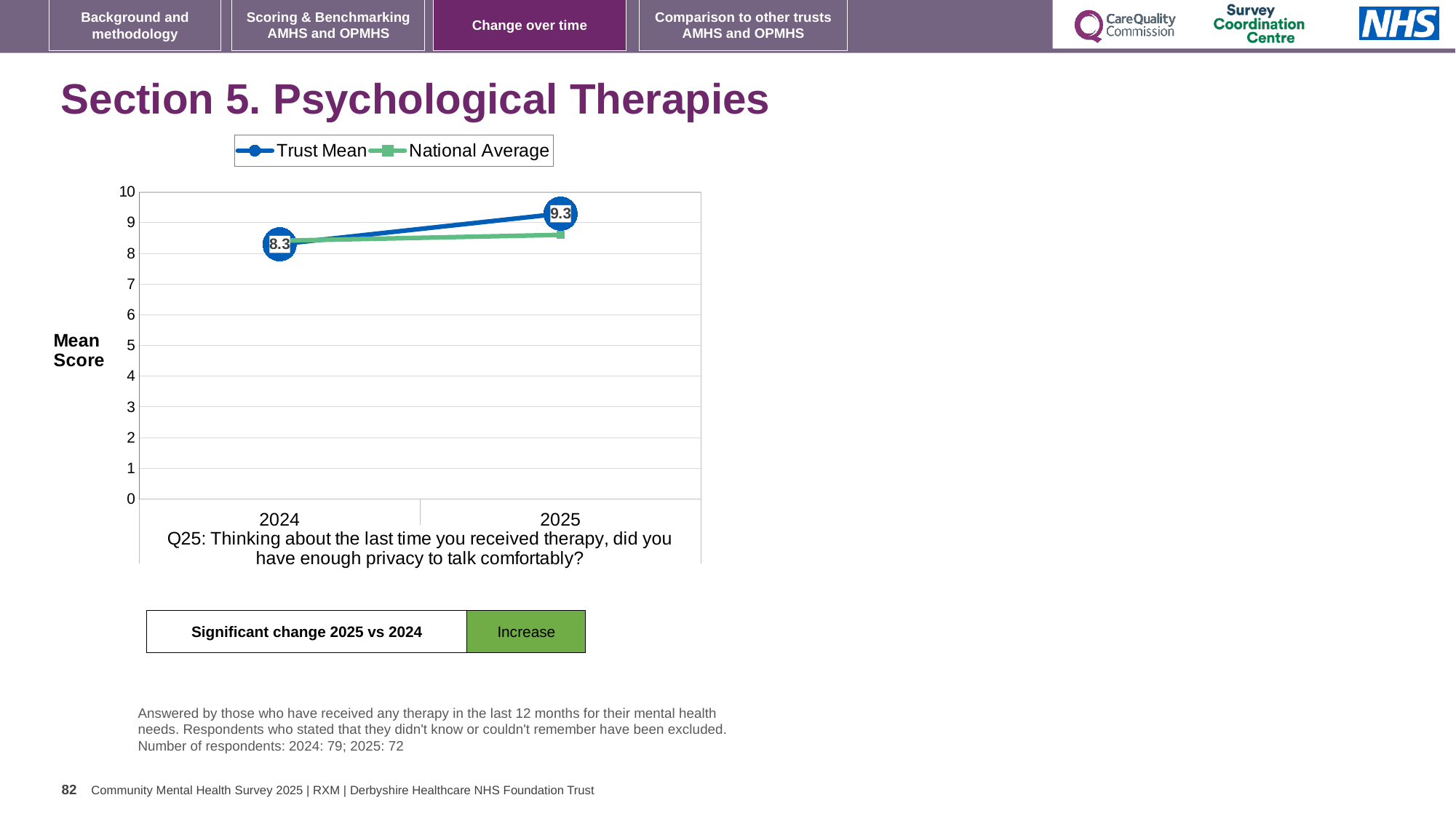
Does the Trust Mean rise or fall from 2024 to 2025? rise How many years are plotted on the x axis? 2 By how much did the Trust Mean change from 2024 to 2025? 1.0 What is the Trust Mean value for 2024? 8.3 In which year is the Trust Mean higher, 2024 or 2025? 2025 What kind of chart is shown on the slide? line chart What are the two series named in the legend? Trust Mean and National Average Is the National Average value for 2025 greater or less than 9? less Is the National Average value for 2024 greater or less than 8? greater How many series does the legend list? 2 In 2025, which is larger, the Trust Mean or the National Average? Trust Mean What is the Trust Mean value for 2025? 9.3